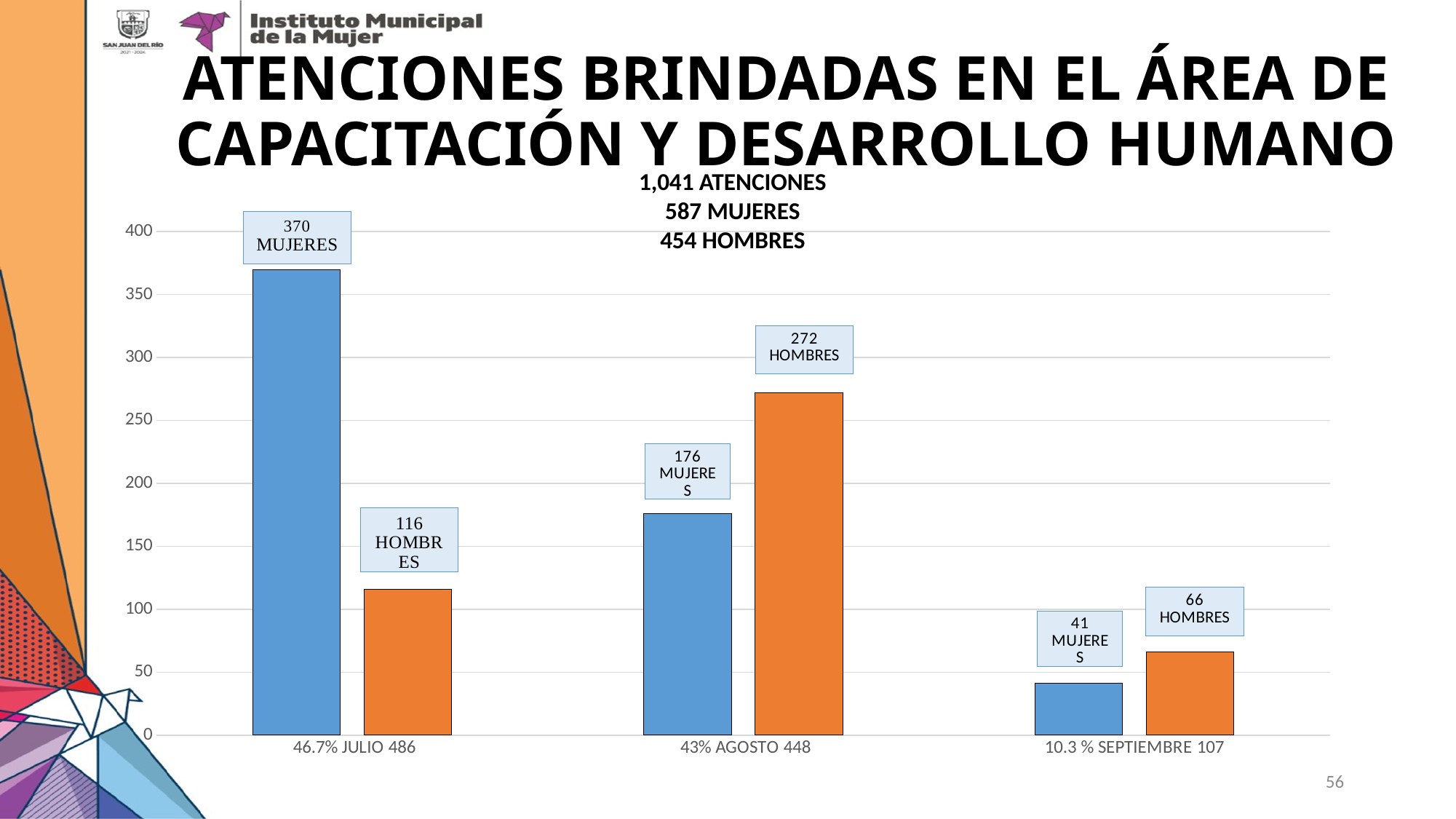
In AGOSTO, which is larger, MUJERES or HOMBRES? HOMBRES What is the difference between MUJERES and HOMBRES in JULIO? 254 What kind of chart is shown on the slide? bar chart Which bar in the chart has the highest value? 370 MUJERES (JULIO) How many months (categories) are shown on the x axis of the chart? 3 What total number of ATENCIONES is printed above the chart? 1,041 What is the value for MUJERES in JULIO? 370 What is the value for HOMBRES in AGOSTO? 272 What is the value for HOMBRES in JULIO? 116 What is the value for MUJERES in SEPTIEMBRE? 41 What is the total number of atenciones for AGOSTO shown on the x-axis label? 448 Which bar in the chart has the lowest value? 41 MUJERES (SEPTIEMBRE)